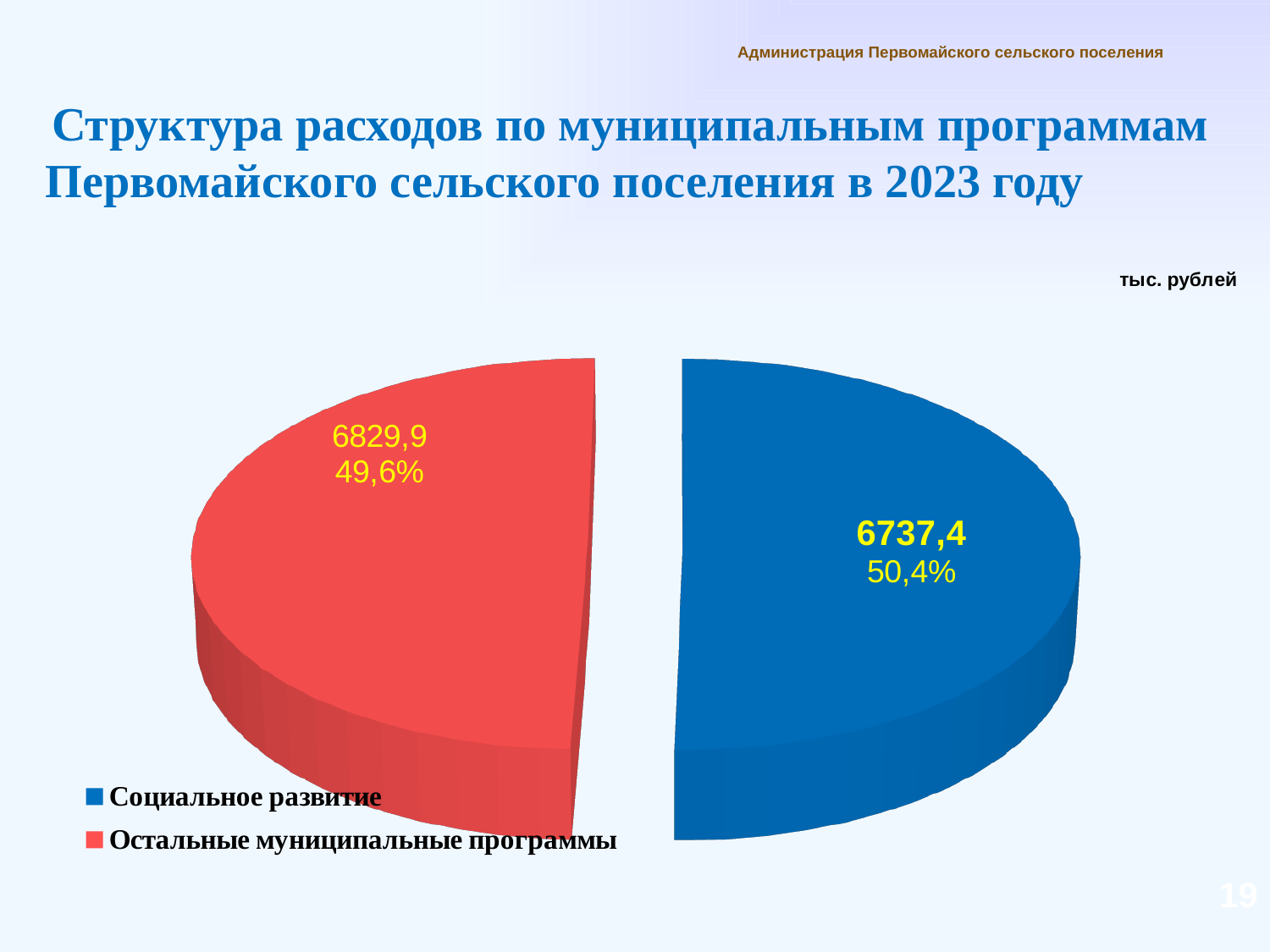
How many slices does the pie chart have? 2 What kind of chart is shown on the slide? pie chart How many entries does the legend list? 2 Which colour represents Социальное развитие in the pie chart? blue What is the value shown for Остальные муниципальные программы? 6829,9 What is the value shown for Социальное развитие? 6737,4 What percentage share is shown for Остальные муниципальные программы? 49,6% What is the total of the two values printed on the pie chart? 13567,3 What is the difference between the printed values for Остальные муниципальные программы and Социальное развитие? 92,5 What unit of measurement is indicated for the chart values? тыс. рублей What percentage share is shown for Социальное развитие? 50,4%